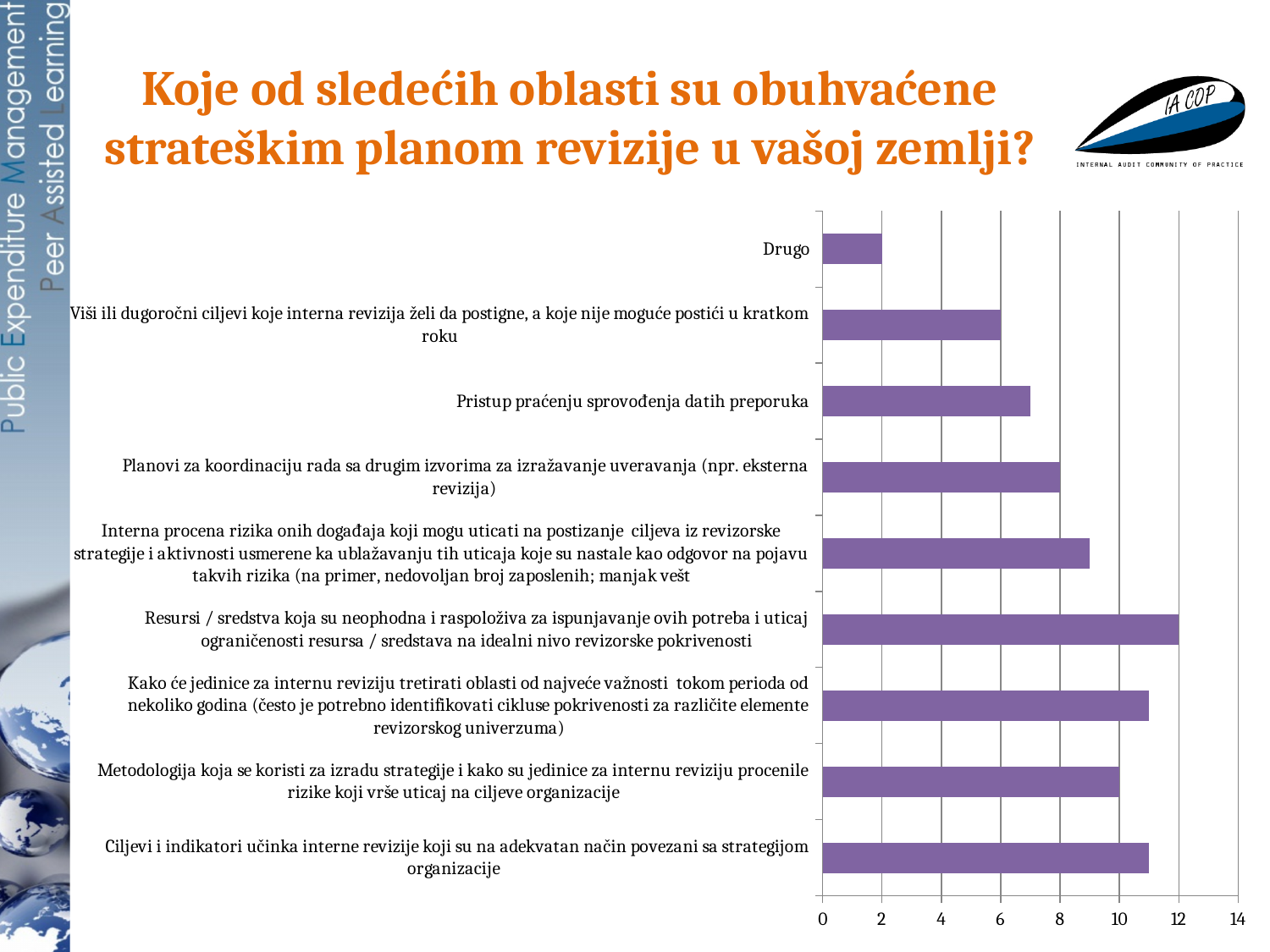
Which category has the lowest value? Drugo How many categories are plotted in the chart? 9 What is the value for "Drugo"? 2 Which category has the highest value? Resursi / sredstva koja su neophodna i raspoloživa za ispunjavanje ovih potreba i uticaj ograničenosti resursa / sredstava na idealni nivo revizorske pokrivenosti What is the value for "Viši ili dugoročni ciljevi koje interna revizija želi da postigne, a koje nije moguće postići u kratkom roku"? 6 Is the value for "Pristup praćenju sprovođenja datih preporuka" greater or less than 8? less Which has the larger value: "Metodologija koja se koristi za izradu strategije..." or "Viši ili dugoročni ciljevi koje interna revizija želi da postigne..."? Metodologija koja se koristi za izradu strategije i kako su jedinice za internu reviziju procenile rizike koji vrše uticaj na ciljeve organizacije What is the value for "Metodologija koja se koristi za izradu strategije i kako su jedinice za internu reviziju procenile rizike koji vrše uticaj na ciljeve organizacije"? 10 What is the value for "Resursi / sredstva koja su neophodna i raspoloživa za ispunjavanje ovih potreba i uticaj ograničenosti resursa / sredstava na idealni nivo revizorske pokrivenosti"? 12 What type of chart is shown on the slide? bar chart Is the value for "Ciljevi i indikatori učinka interne revizije koji su na adekvatan način povezani sa strategijom organizacije" greater or less than 10? greater What is the difference between the value for "Resursi / sredstva..." and the value for "Drugo"? 10